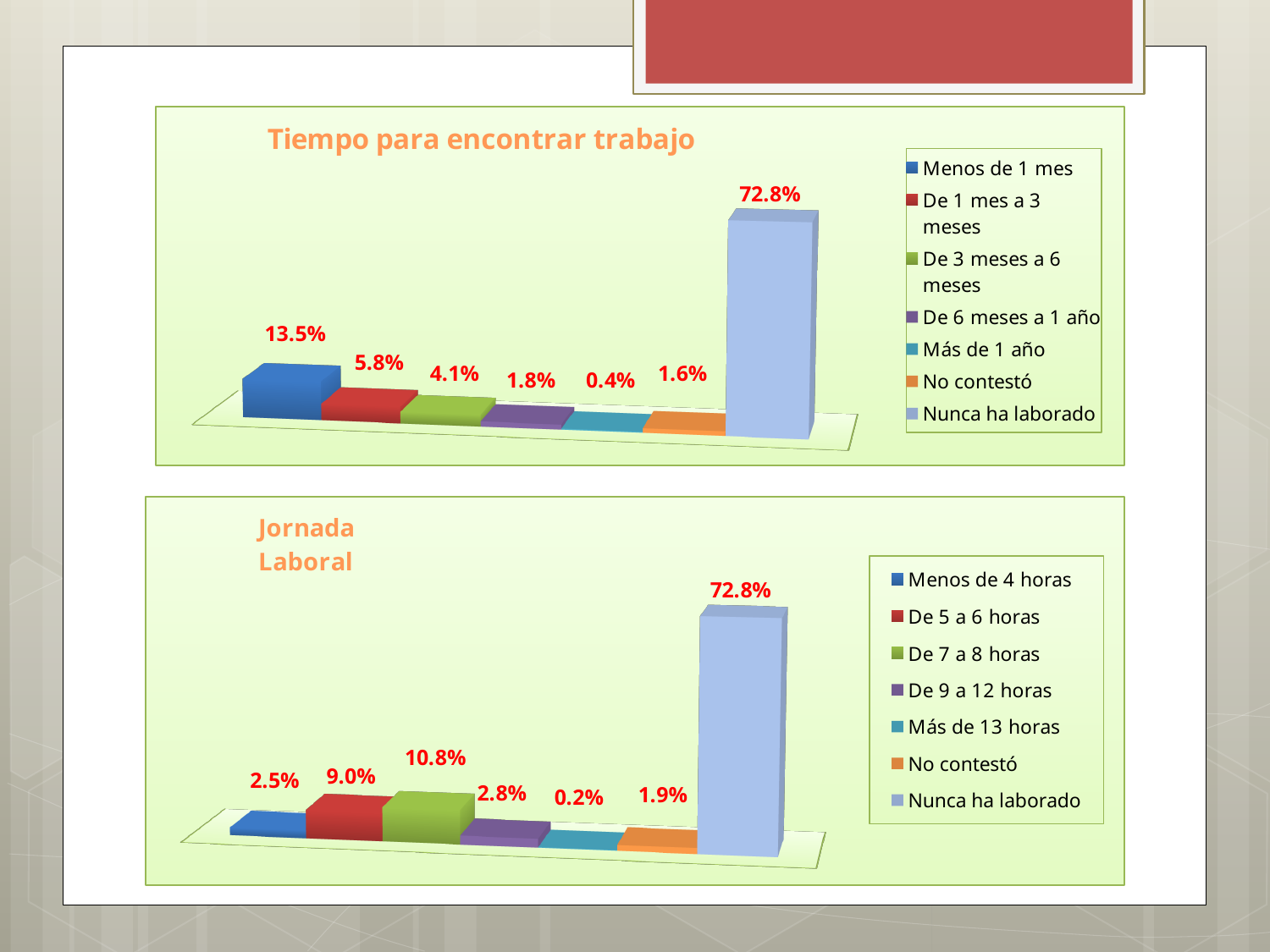
In the 'Jornada Laboral' chart, what is the value for 'De 7 a 8 horas'? 10.8% In the 'Tiempo para encontrar trabajo' chart, which category has the lowest value? Más de 1 año In the 'Tiempo para encontrar trabajo' chart, what is the value for 'De 3 meses a 6 meses'? 4.1% In the 'Jornada Laboral' chart, what colour is the bar for 'No contestó'? Orange In the 'Tiempo para encontrar trabajo' chart, what is the value for 'Menos de 1 mes'? 13.5% In the 'Tiempo para encontrar trabajo' chart, what is the difference between 'Menos de 1 mes' and 'De 1 mes a 3 meses'? 7.7% In the 'Jornada Laboral' chart, what is the difference between 'De 7 a 8 horas' and 'Menos de 4 horas'? 8.3% What kind of chart is the 'Jornada Laboral' chart? Bar chart In the 'Tiempo para encontrar trabajo' chart, how many categories does the legend list? 7 In the 'Jornada Laboral' chart, what is the value for 'Más de 13 horas'? 0.2% In the 'Tiempo para encontrar trabajo' chart, which category has the highest value? Nunca ha laborado In the 'Jornada Laboral' chart, which is larger, 'De 5 a 6 horas' or 'De 9 a 12 horas'? De 5 a 6 horas